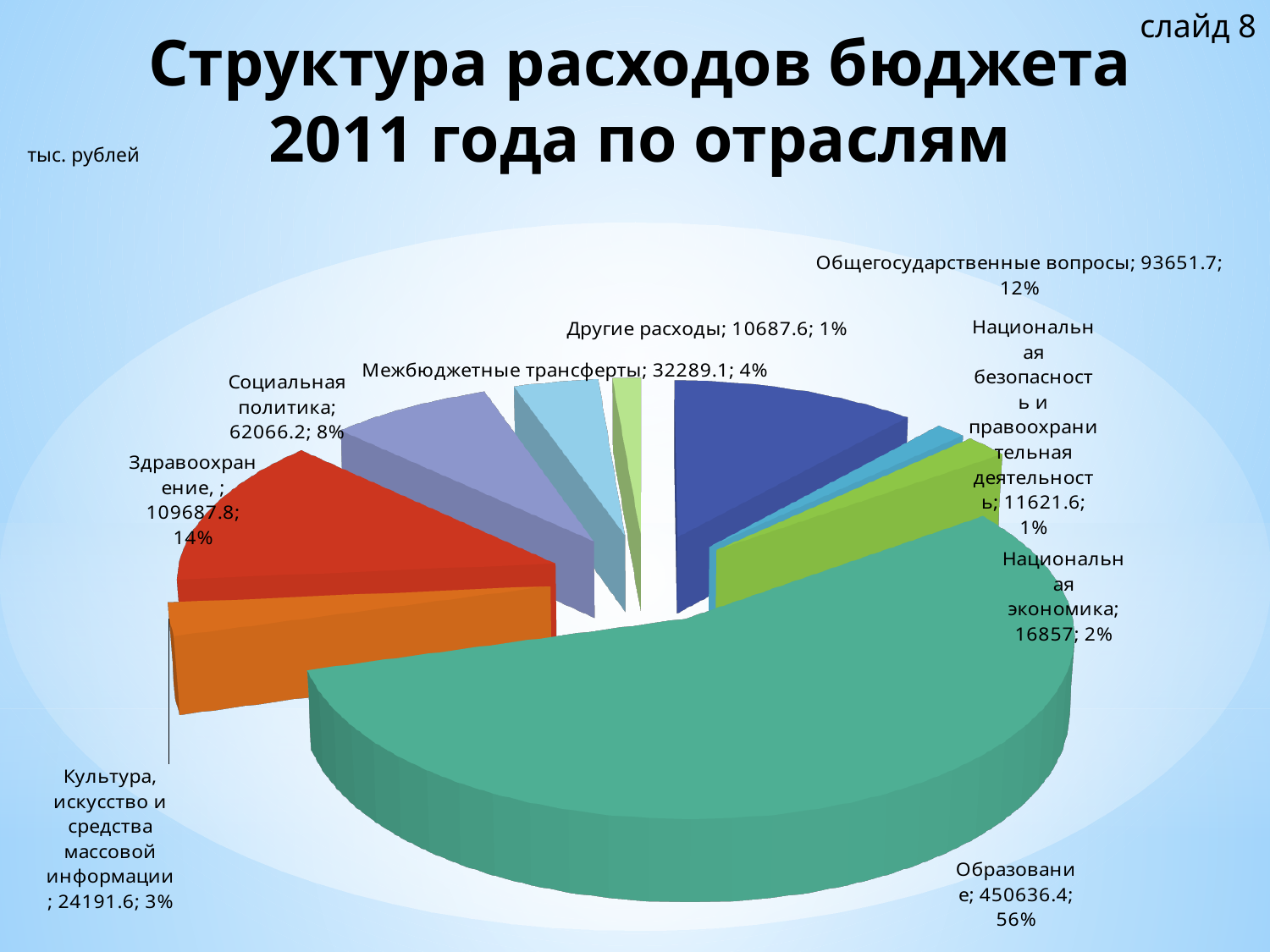
What share of the pie does Социальная политика represent? 8% What share of the pie does Образование represent? 56% How many categories (slices) does the pie chart show? 9 What is the value for Здравоохранение? 109687.8 What is the value for Образование? 450636.4 Which category has the largest value? Образование What is the difference between the values for Здравоохранение and Социальная политика? 47621.6 What type of chart is shown on the slide? pie chart Which category has the smallest value? Другие расходы What unit of measurement is indicated on the slide for the chart values? тыс. рублей What is the value for Общегосударственные вопросы? 93651.7 Which is larger, the value for Межбюджетные трансферты or the value for Культура, искусство и средства массовой информации? Межбюджетные трансферты